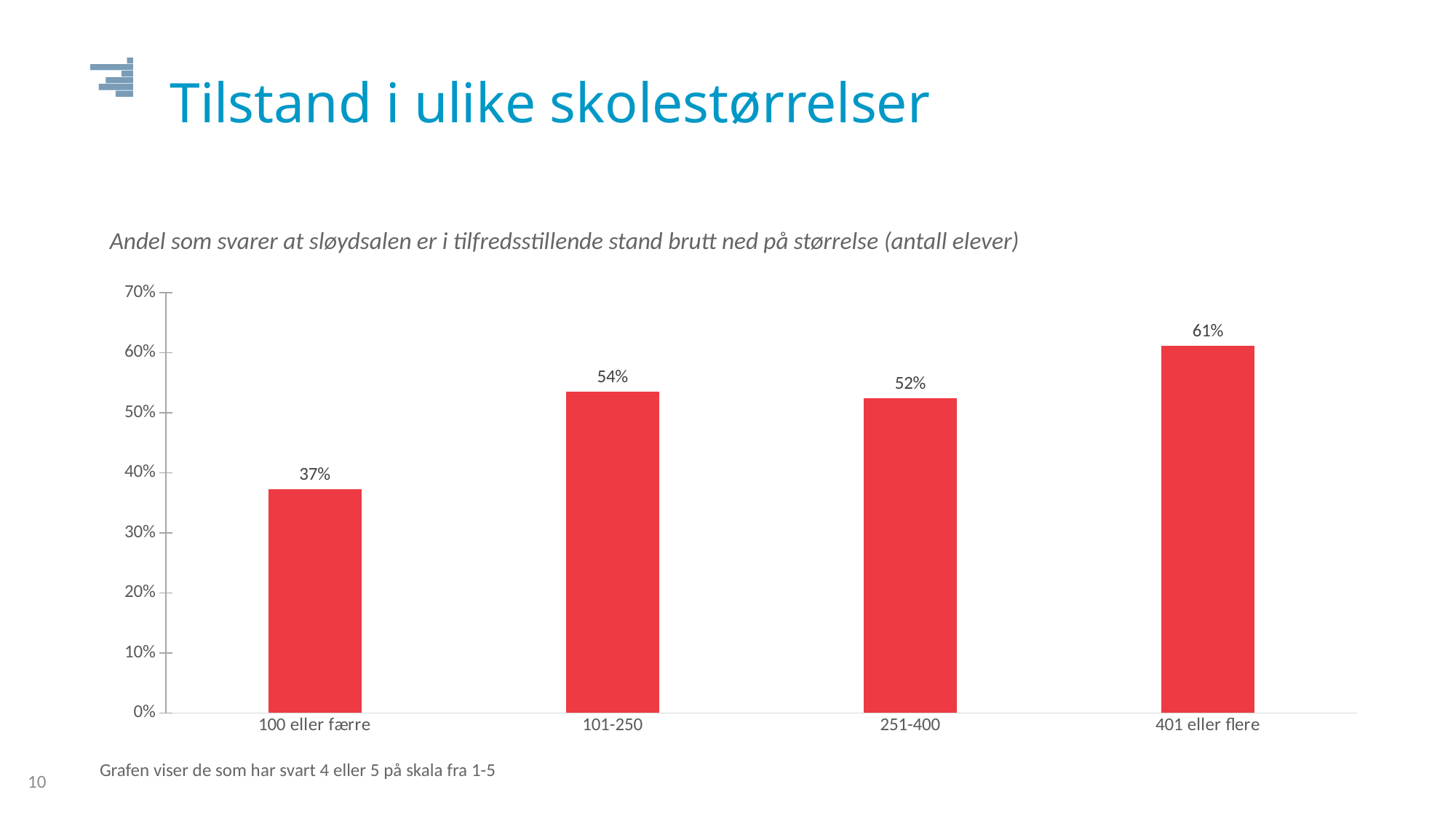
Which category has the highest value? 401 eller flere What is the difference between the values for '401 eller flere' and '100 eller færre'? 24% Which is larger, the value for '101-250' or the value for '251-400'? 101-250 Which category has the lowest value? 100 eller færre What kind of chart is shown on the slide? bar chart What is the value for the '101-250' category? 54% What is the chart's subtitle text above the plot area? Andel som svarer at sløydsalen er i tilfredsstillende stand brutt ned på størrelse (antall elever) What is the value for the '401 eller flere' category? 61% How many categories are shown on the x axis? 4 What is the value for the '100 eller færre' category? 37% What is the value for the '251-400' category? 52% Is the value for '100 eller færre' greater or less than 40%? less